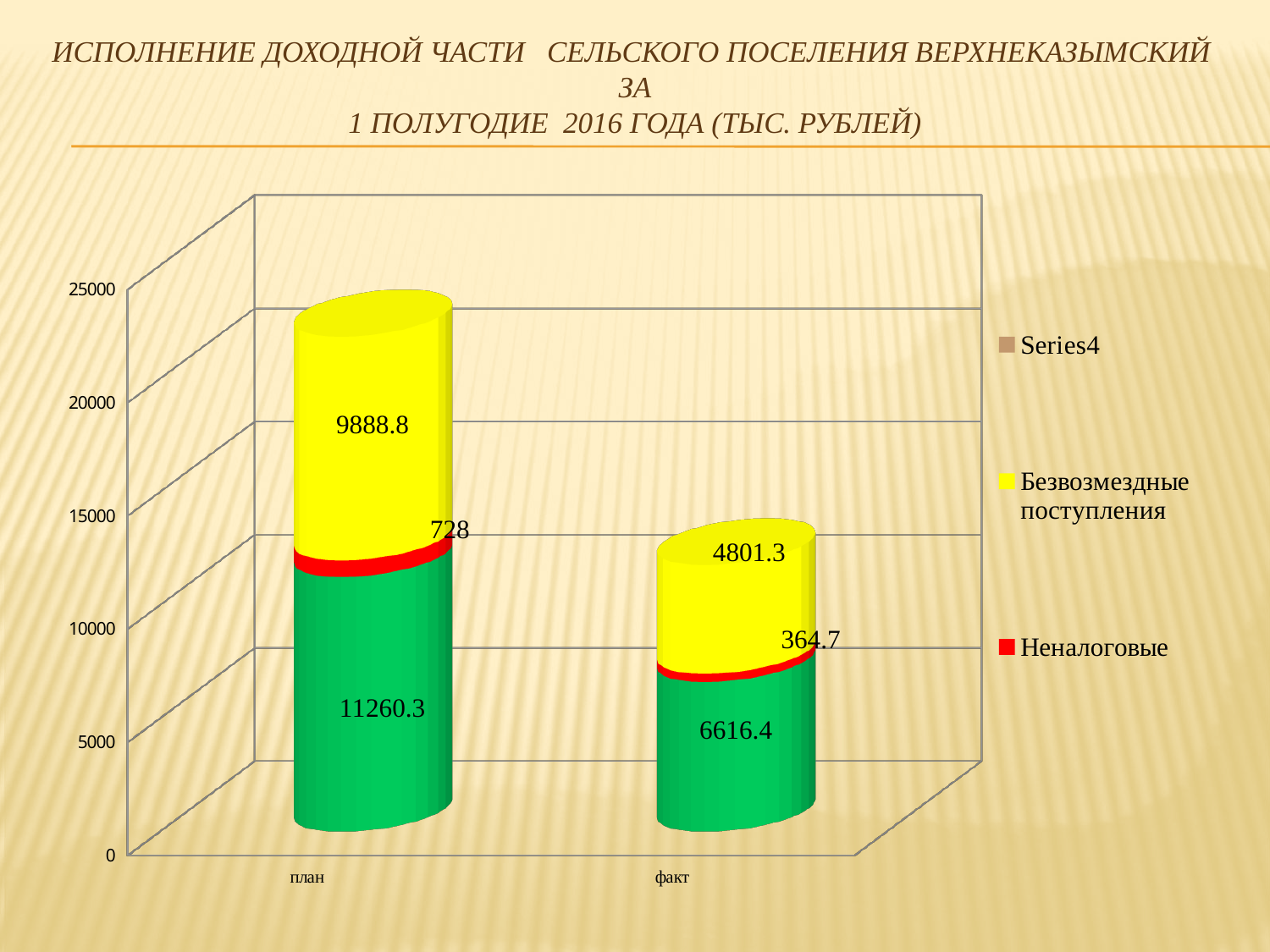
What is the total of the stacked bar for факт? 11782.4 What is the total of the stacked bar for план? 21877.1 What is the difference between the Безвозмездные поступления values for план and факт? 5087.5 What is the value of Безвозмездные поступления for план? 9888.8 Which category has the larger Безвозмездные поступления value, план or факт? план What is the value of Неналоговые for план? 728 What is the difference between the Неналоговые values for план and факт? 363.3 What kind of chart is shown on the slide? Stacked bar chart How many categories are shown on the x axis? 2 What is the value of Безвозмездные поступления for факт? 4801.3 What is the value of the green segment for факт? 6616.4 What is the value of Неналоговые for факт? 364.7